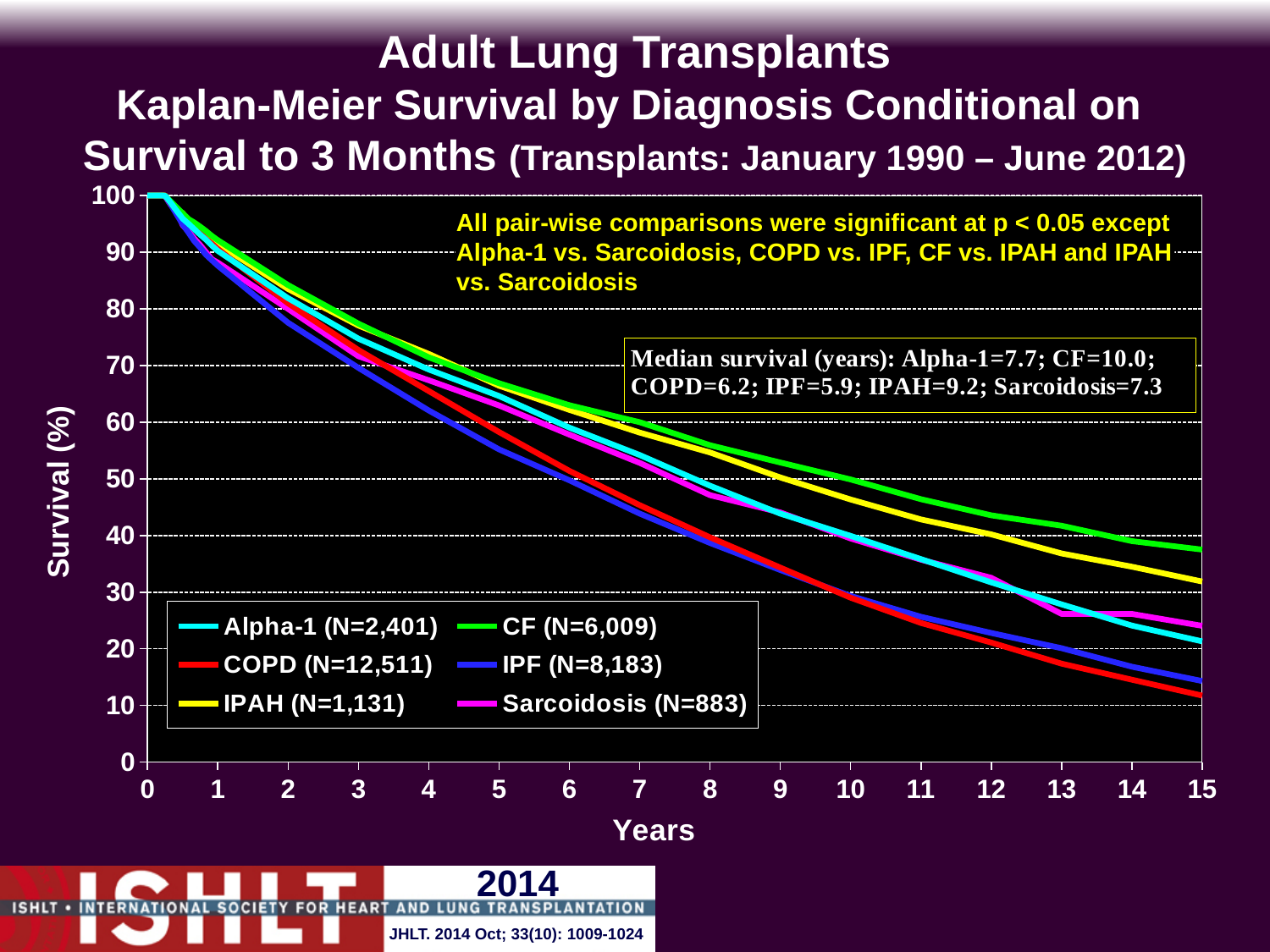
Which diagnosis curve is lowest at 15 years? COPD According to the text box, what is the median survival in years for CF? 10.0 Which diagnosis has the highest median survival listed in the text box? CF What kind of chart is shown on the slide? line chart Which diagnosis has the lowest median survival listed in the text box? IPF Is the survival value for COPD at 15 years greater or less than 20? less According to the text box, what is the median survival in years for IPF? 5.9 Which diagnosis curve is highest at 15 years? CF Do the survival curves rise or fall as years increase? fall What is the N shown in the legend for COPD? 12,511 What is the difference in median survival (years) between CF and IPF? 4.1 How many series does the legend list? 6